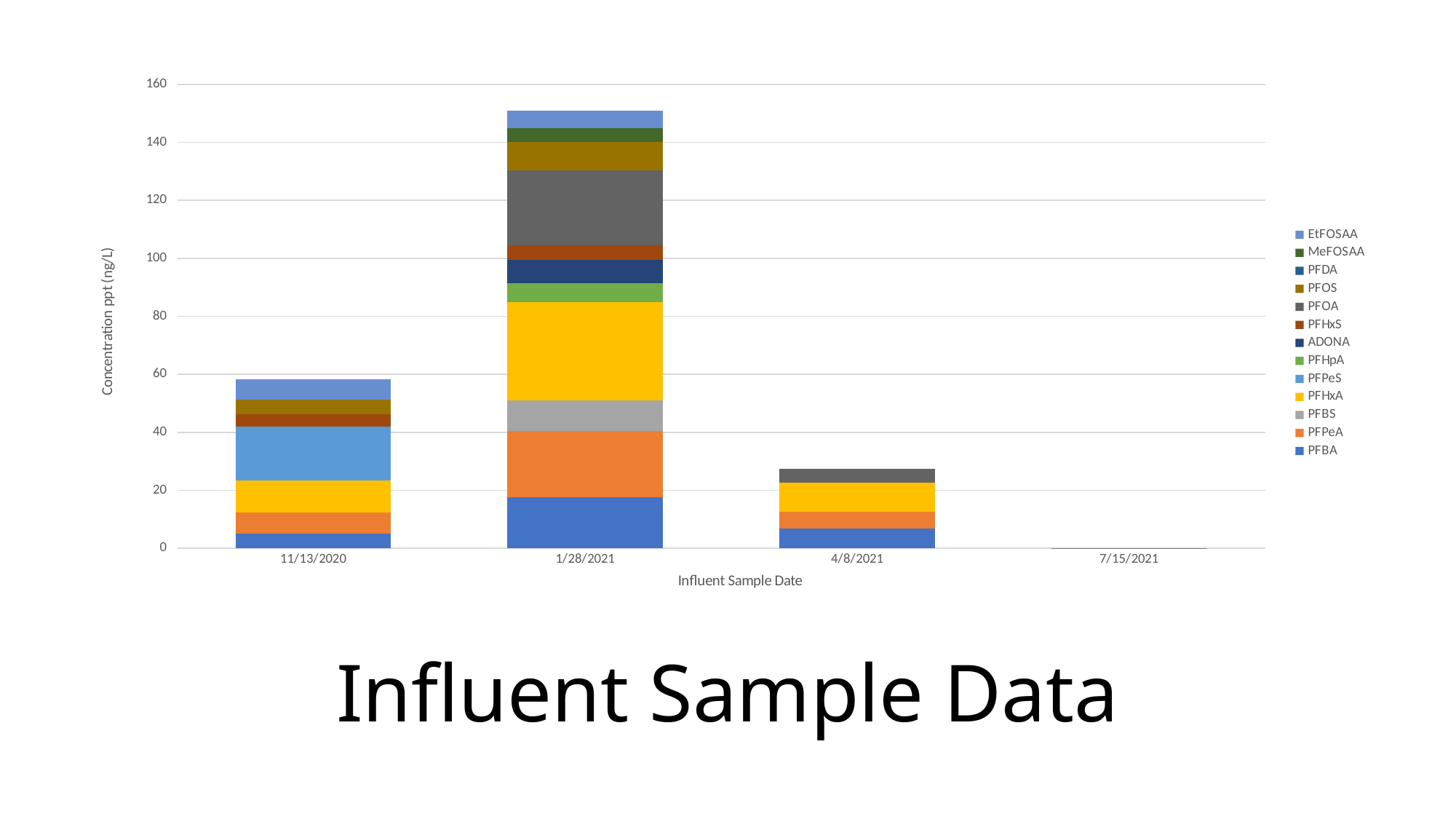
Is the total concentration for 11/13/2020 greater or less than 40? greater How many sample dates are shown on the x axis? 4 Does the total concentration rise or fall from 1/28/2021 to 7/15/2021? fall What kind of chart is shown on the slide? Stacked bar chart Which sample date has the highest total concentration? 1/28/2021 Which sample date has the lowest total concentration? 7/15/2021 What is the label on the x axis? Influent Sample Date Which has the larger total concentration, 11/13/2020 or 4/8/2021? 11/13/2020 What is the label on the y axis? Concentration ppt (ng/L) How many series does the legend list? 13 Is the total concentration for 4/8/2021 greater or less than 40? less Is the total concentration for 1/28/2021 greater or less than 140? greater